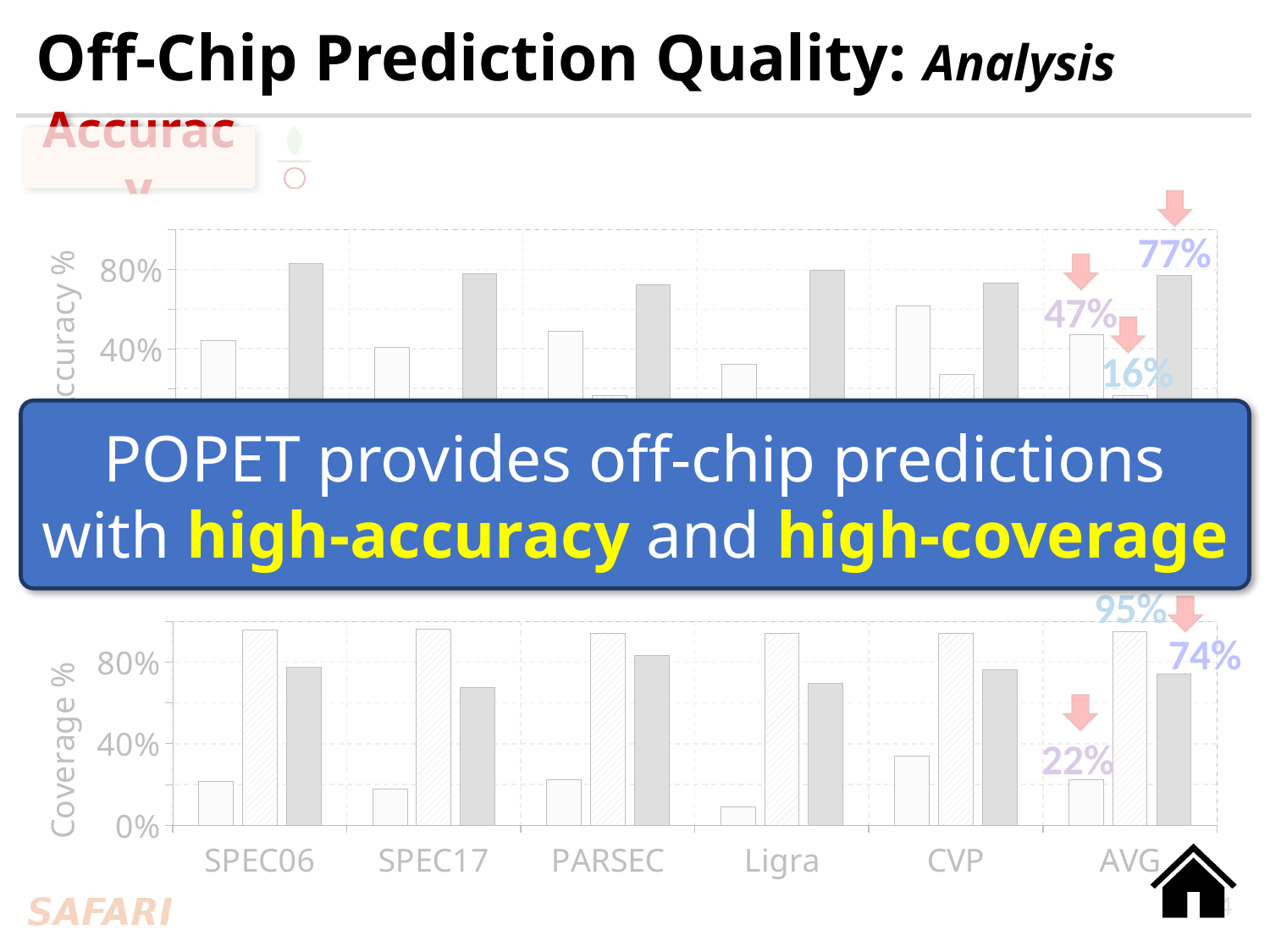
In the bottom chart (Coverage %), what is the difference between the labelled AVG values 95% and 74%? 21 percentage points In the top chart (Accuracy %), which of the three labelled AVG values is the lowest? 16% In the bottom chart (Coverage %), is the value of the first bar for SPEC06 greater or less than 40%? less In the bottom chart (Coverage %), which of the three labelled AVG values is the highest? 95% In the bottom chart (Coverage %), what value is labelled on the third bar of the AVG group? 74% In the top chart (Accuracy %), what is the difference between the labelled AVG values 77% and 47%? 30 percentage points In the bottom chart (Coverage %), which has the larger first bar, CVP or Ligra? CVP In the top chart (Accuracy %), what value is labelled on the third bar of the AVG group? 77% In the bottom chart (Coverage %), what value is labelled on the first bar of the AVG group? 22% How many categories are shown along the x axis of the bottom chart (Coverage %)? 6 In the top chart (Accuracy %), what value is labelled on the first bar of the AVG group? 47% What kind of chart is the top chart (Accuracy %) on the slide? bar chart